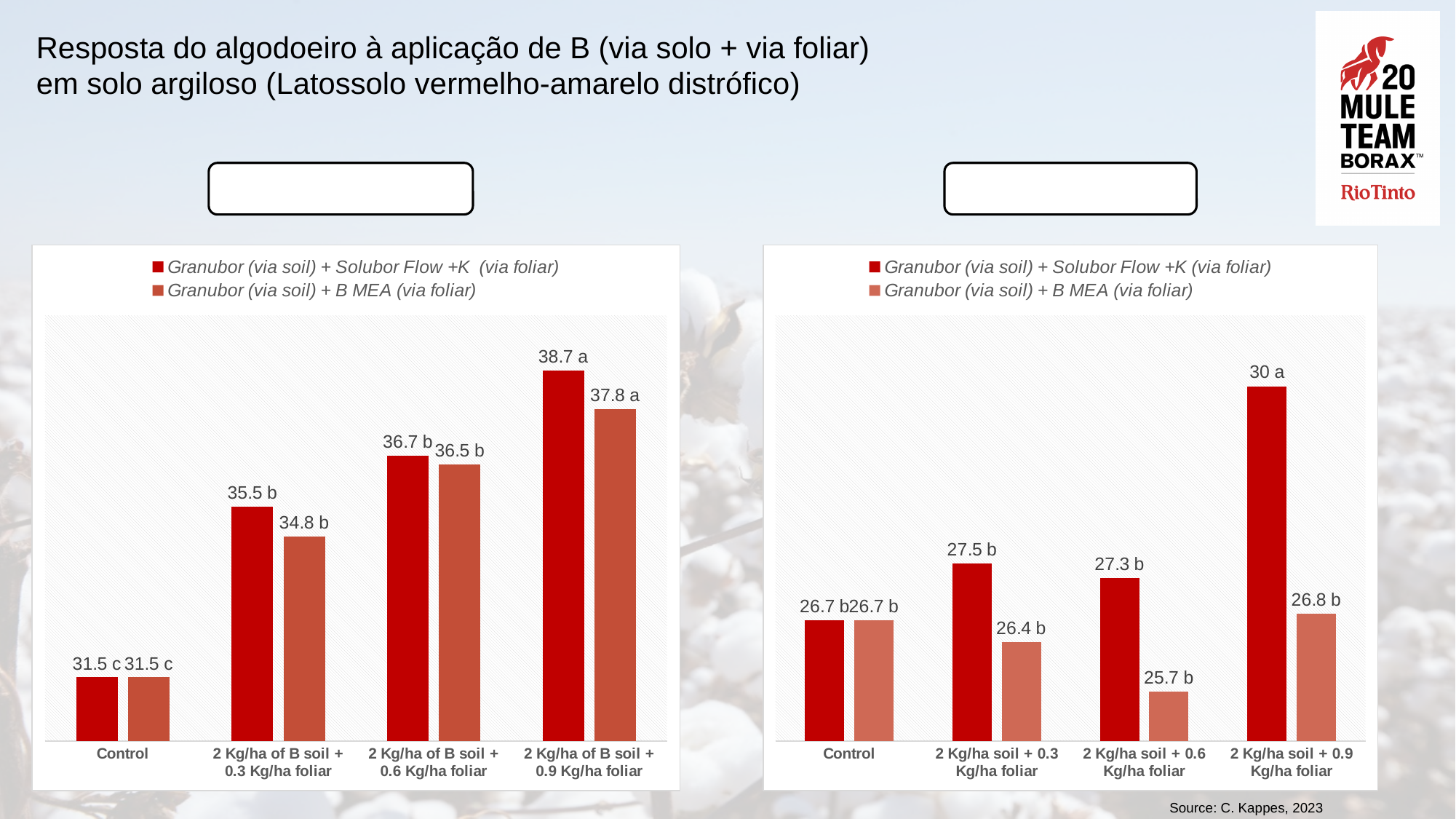
On the right chart, what is the difference between the two series at 2 Kg/ha soil + 0.9 Kg/ha foliar? 3.2 On the left chart, what is the value for Granubor (via soil) + Solubor Flow +K (via foliar) at 2 Kg/ha of B soil + 0.9 Kg/ha foliar? 38.7 a On the left chart, what is the difference between the two series at 2 Kg/ha of B soil + 0.9 Kg/ha foliar? 0.9 On the left chart, which category has the highest value for Granubor (via soil) + Solubor Flow +K (via foliar)? 2 Kg/ha of B soil + 0.9 Kg/ha foliar How many categories are shown on the x axis of the left chart? 4 On the right chart, which series has the larger value at 2 Kg/ha soil + 0.3 Kg/ha foliar? Granubor (via soil) + Solubor Flow +K (via foliar) On the right chart, what is the value for Granubor (via soil) + Solubor Flow +K (via foliar) at 2 Kg/ha soil + 0.9 Kg/ha foliar? 30 a On the left chart, what is the value for Granubor (via soil) + B MEA (via foliar) at 2 Kg/ha of B soil + 0.3 Kg/ha foliar? 34.8 b What kind of chart is the left chart? Bar chart On the right chart, what is the value for Granubor (via soil) + B MEA (via foliar) at 2 Kg/ha soil + 0.6 Kg/ha foliar? 25.7 b On the right chart, which category has the lowest value for Granubor (via soil) + B MEA (via foliar)? 2 Kg/ha soil + 0.6 Kg/ha foliar How many series does the legend of the right chart list? 2